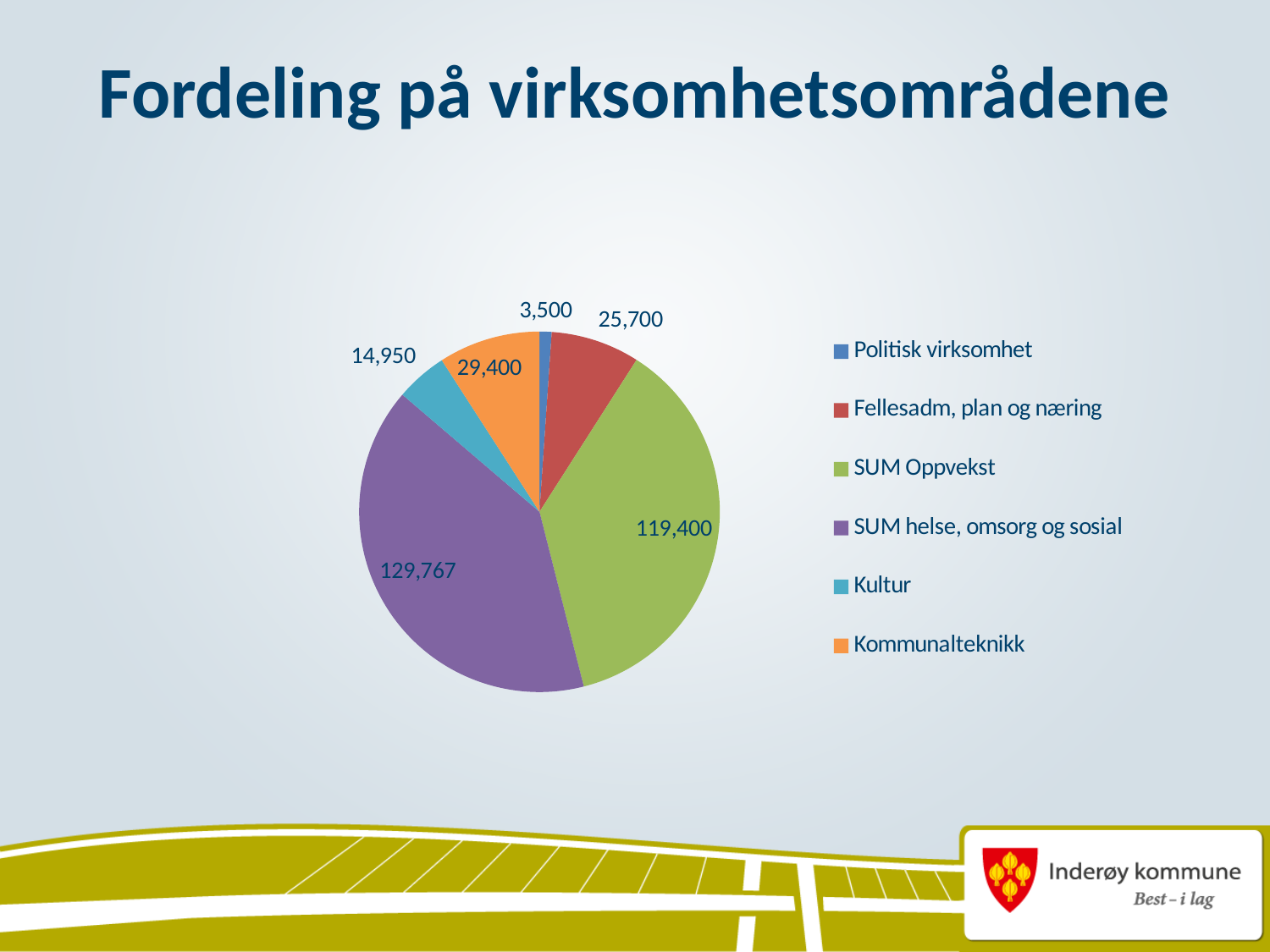
What is the value for SUM Oppvekst? 119,400 Which is larger, Kommunalteknikk or Kultur? Kommunalteknikk What kind of chart is shown on the slide? Pie chart What is the title of the slide? Fordeling på virksomhetsområdene What is the value for Kultur? 14,950 What is the difference between SUM helse, omsorg og sosial and SUM Oppvekst? 10,367 Which category has the smallest slice of the pie? Politisk virksomhet Which category has the largest slice of the pie? SUM helse, omsorg og sosial How many categories does the pie chart show? 6 What is the value for Politisk virksomhet? 3,500 What is the difference between Kommunalteknikk and Fellesadm, plan og næring? 3,700 What is the value for Kommunalteknikk? 29,400